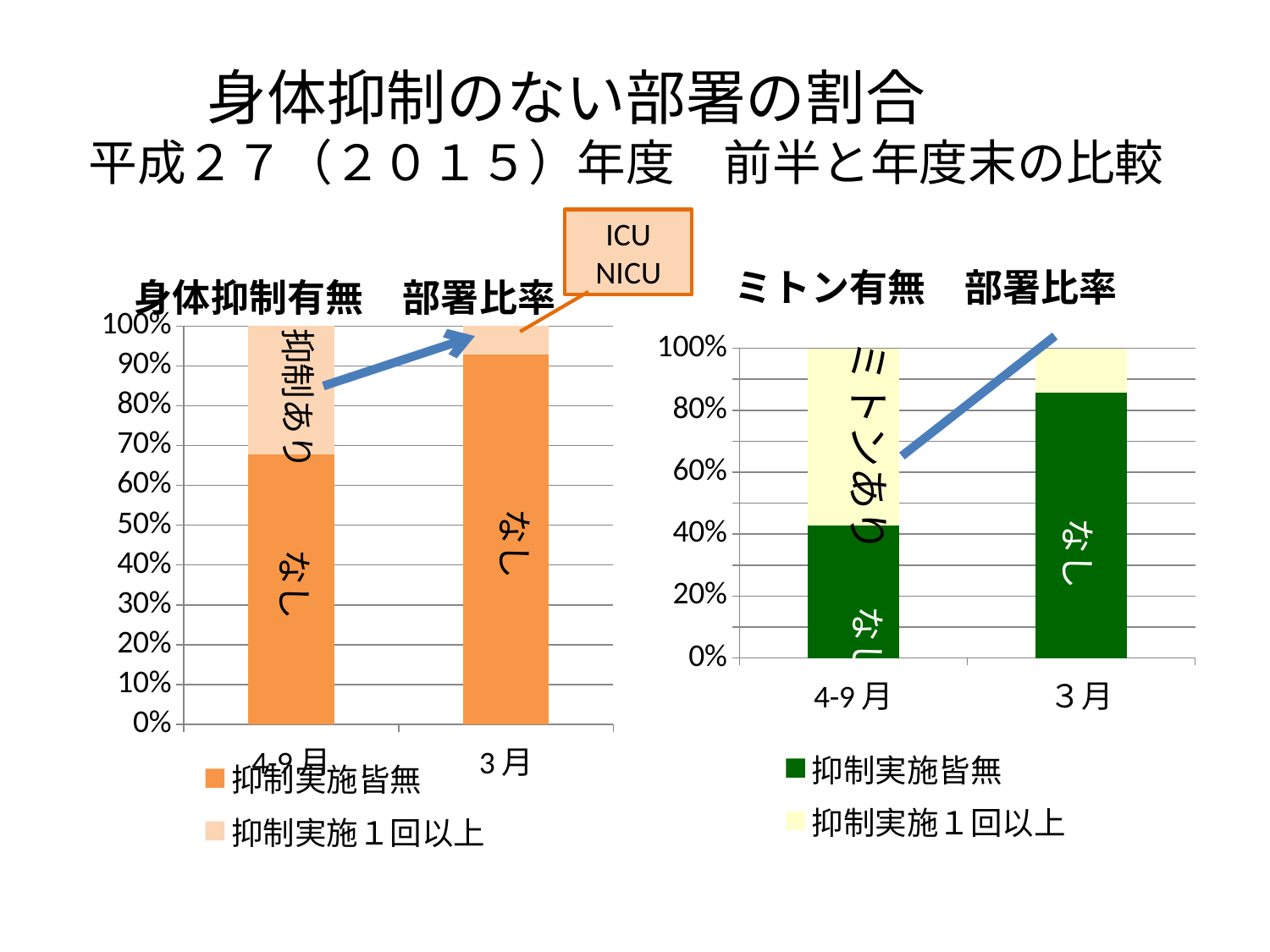
In the right chart titled ミトン有無 部署比率, which category has the larger share of 抑制実施1回以上, 4-9月 or 3月? 4-9月 In the right chart titled ミトン有無 部署比率, does the share of 抑制実施皆無 rise or fall from 4-9月 to 3月? rise In the right chart titled ミトン有無 部署比率, is the value for 抑制実施皆無 in 3月 greater or less than 60%? greater How many categories are shown on the x axis of the right chart titled ミトン有無 部署比率? 2 In the left chart titled 身体抑制有無 部署比率, is the value for 抑制実施皆無 in 3月 greater or less than 80%? greater What is the title of the right chart? ミトン有無 部署比率 What kind of chart is the left chart titled 身体抑制有無 部署比率? bar chart What are the two legend entries of the right chart titled ミトン有無 部署比率? 抑制実施皆無, 抑制実施1回以上 In the left chart titled 身体抑制有無 部署比率, is the value for 抑制実施皆無 in 4-9月 greater or less than 50%? greater How many series does the legend of the left chart titled 身体抑制有無 部署比率 list? 2 In the left chart titled 身体抑制有無 部署比率, which category has the larger share of 抑制実施皆無, 4-9月 or 3月? 3月